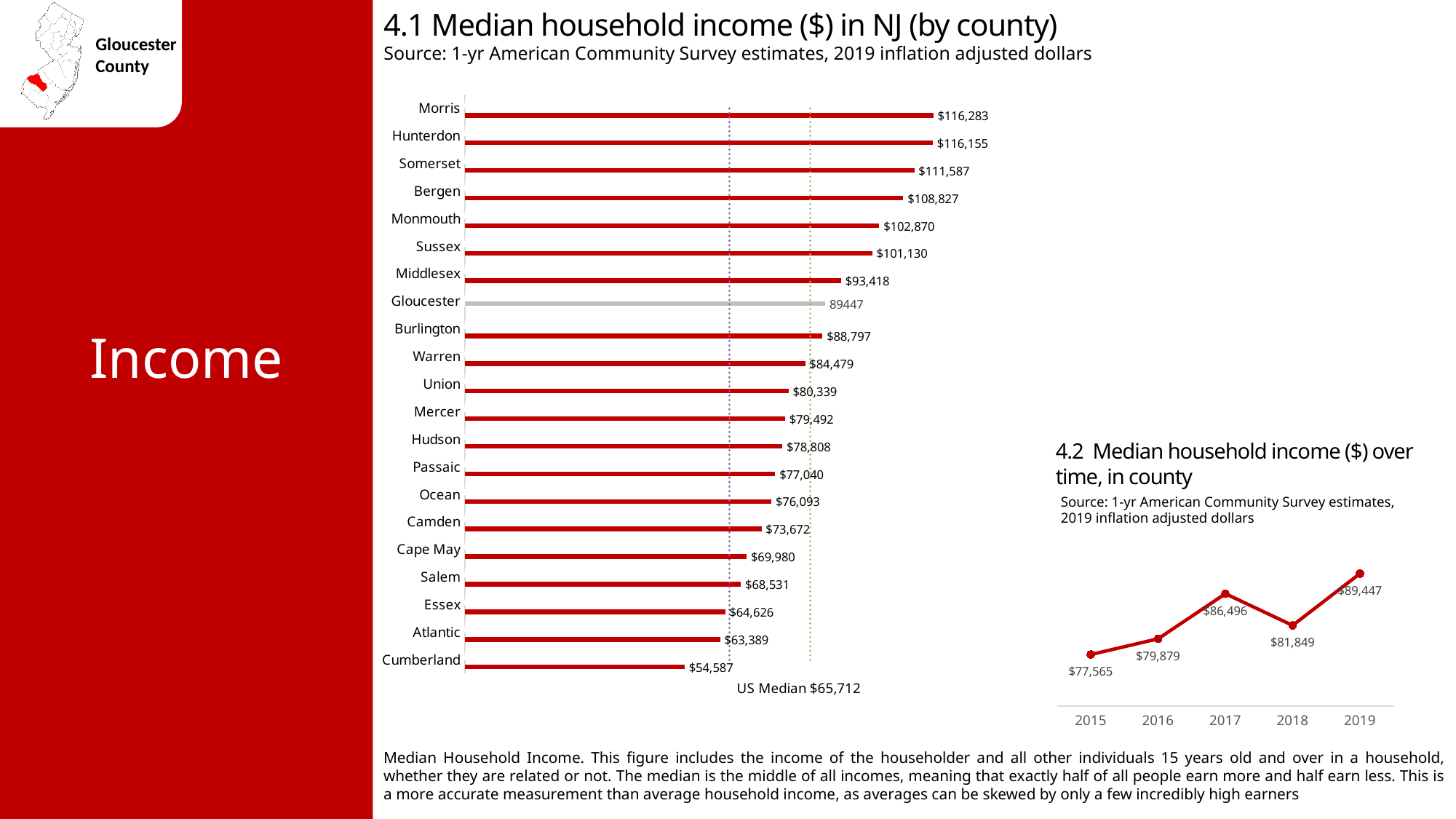
In chart 4.2 (Median household income over time, in county), what is the value for 2017? $86,496 In chart 4.2, what is the difference between the 2019 and 2015 values? $11,882 In chart 4.1, what US Median value is labeled at the bottom of the chart? $65,712 What kind of chart is chart 4.1? Bar chart In chart 4.1, what is the difference between the median household income of Morris and Cumberland? $61,696 In chart 4.2, which year has the highest median household income? 2019 In chart 4.1, what is the median household income for Camden county? $73,672 In chart 4.1 (Median household income in NJ by county), what is the median household income for Gloucester? 89447 In chart 4.1, which county has a higher median household income, Bergen or Middlesex? Bergen In chart 4.1, which county has the lowest median household income? Cumberland In chart 4.1, what is the median household income for Bergen county? $108,827 In chart 4.1, how many counties are shown? 21